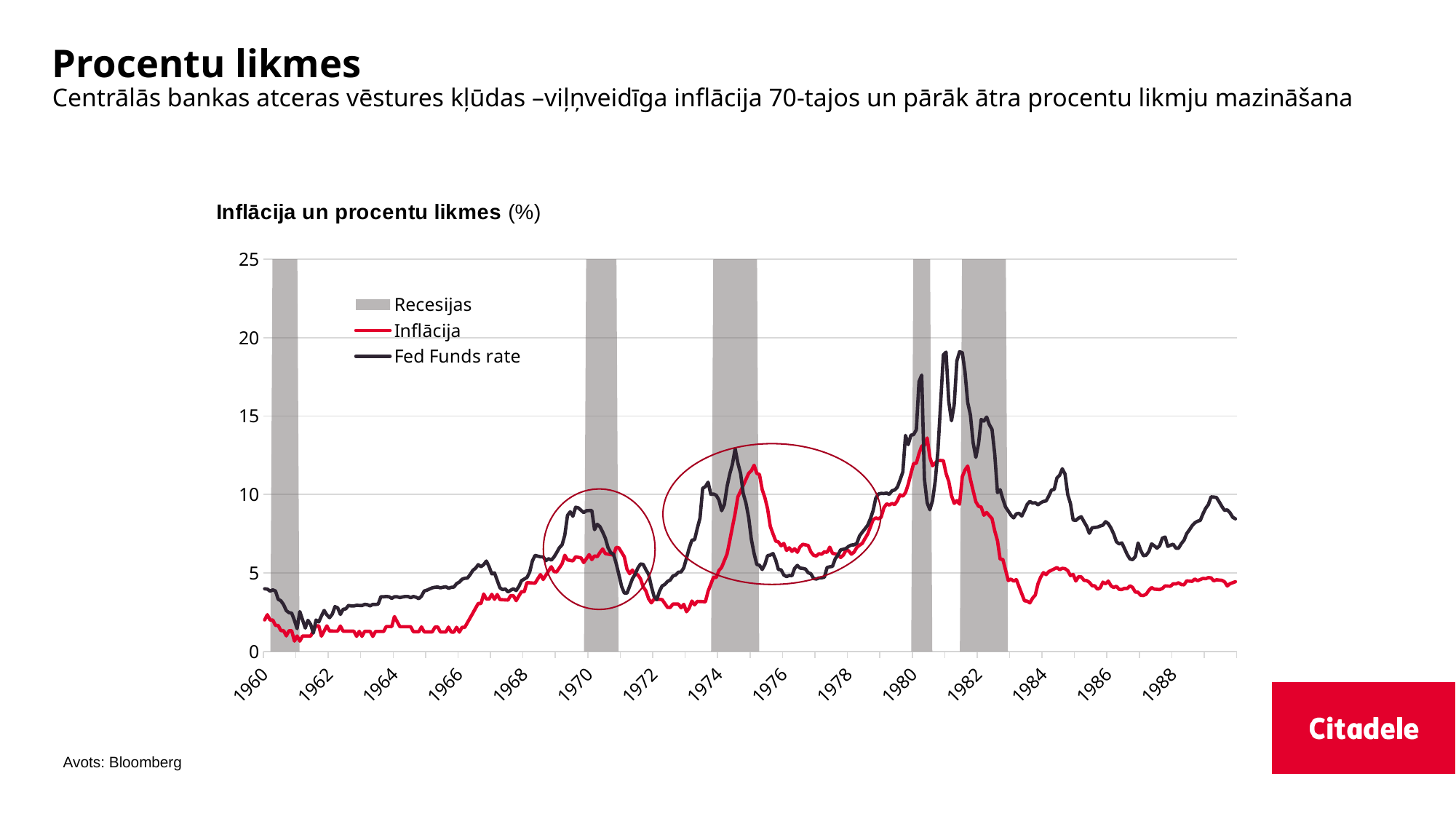
Does the Fed Funds rate generally rise or fall between 1960 and 1970? rise Is the peak value of the Fed Funds rate around 1981 greater or less than 15? greater Is the value of Inflācija in 1962 greater or less than 5? less What kind of chart is shown on the slide? line chart What is the title of the chart? Inflācija un procentu likmes (%) How many shaded recession (Recesijas) bands are shown on the chart? 5 At the inflation peak around 1975, which is higher: Inflācija or the Fed Funds rate? Inflācija Is the value of Inflācija in 1986 greater or less than 5? less Around 1981, which is higher: the Fed Funds rate or Inflācija? Fed Funds rate How many entries does the chart legend list? 3 What colour is the Inflācija line in the chart? red